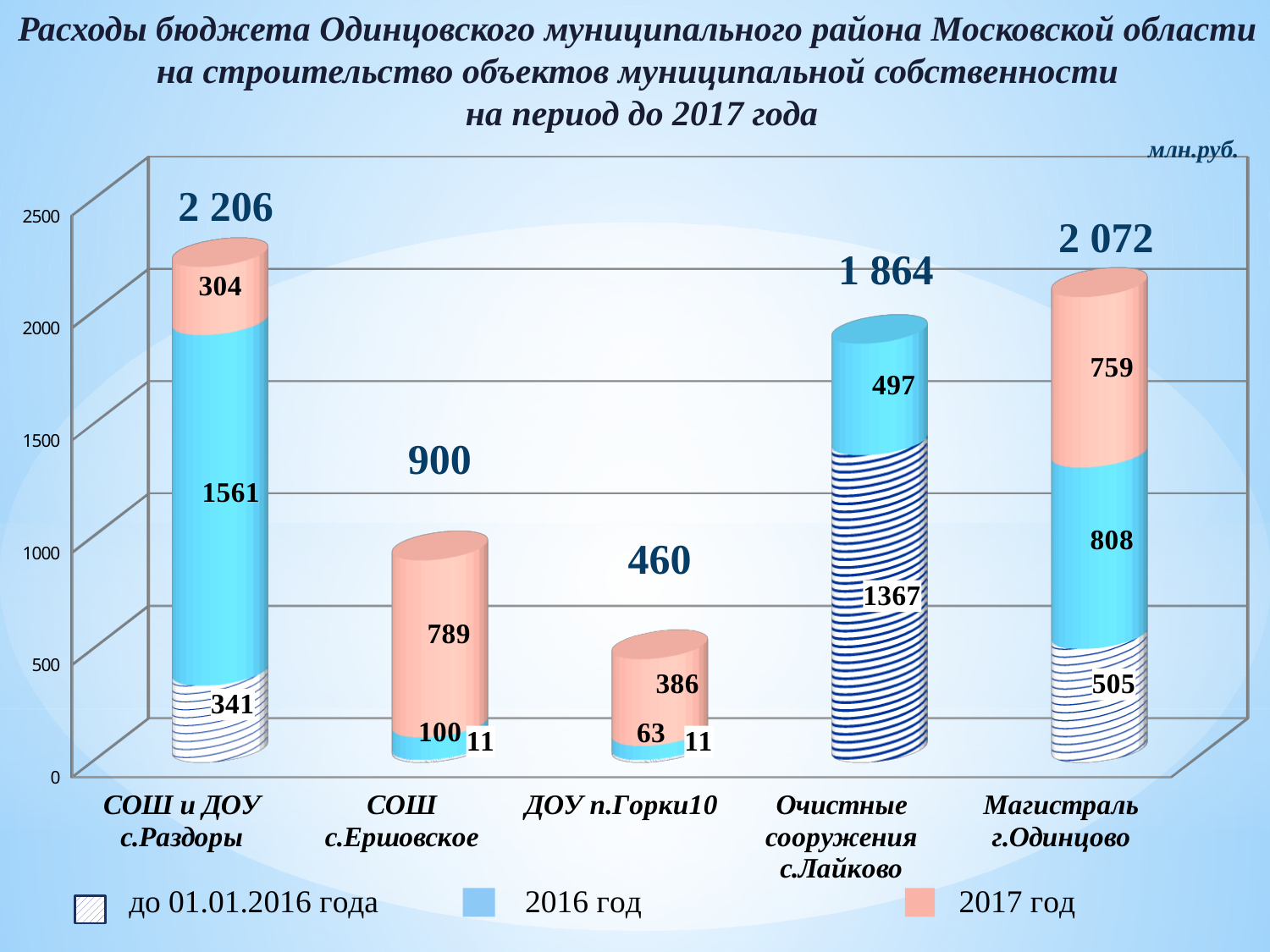
What is the total printed above the bar for Магистраль г.Одинцово? 2 072 How many categories are shown on the x axis? 5 How many series does the legend list? 3 What kind of chart is shown on the slide? Stacked bar chart Which category has the lowest total? ДОУ п.Горки10 What unit is indicated in the top right corner of the chart? млн.руб. What is the до 01.01.2016 года value for Очистные сооружения с.Лайково? 1367 Which is larger: the 2016 год value for Очистные сооружения с.Лайково or the 2016 год value for Магистраль г.Одинцово? Магистраль г.Одинцово What is the 2016 год value for СОШ и ДОУ с.Раздоры? 1561 What is the 2017 год value for СОШ с.Ершовское? 789 Which category has the highest total? СОШ и ДОУ с.Раздоры What is the difference between the 2017 год values for Магистраль г.Одинцово and СОШ и ДОУ с.Раздоры? 455